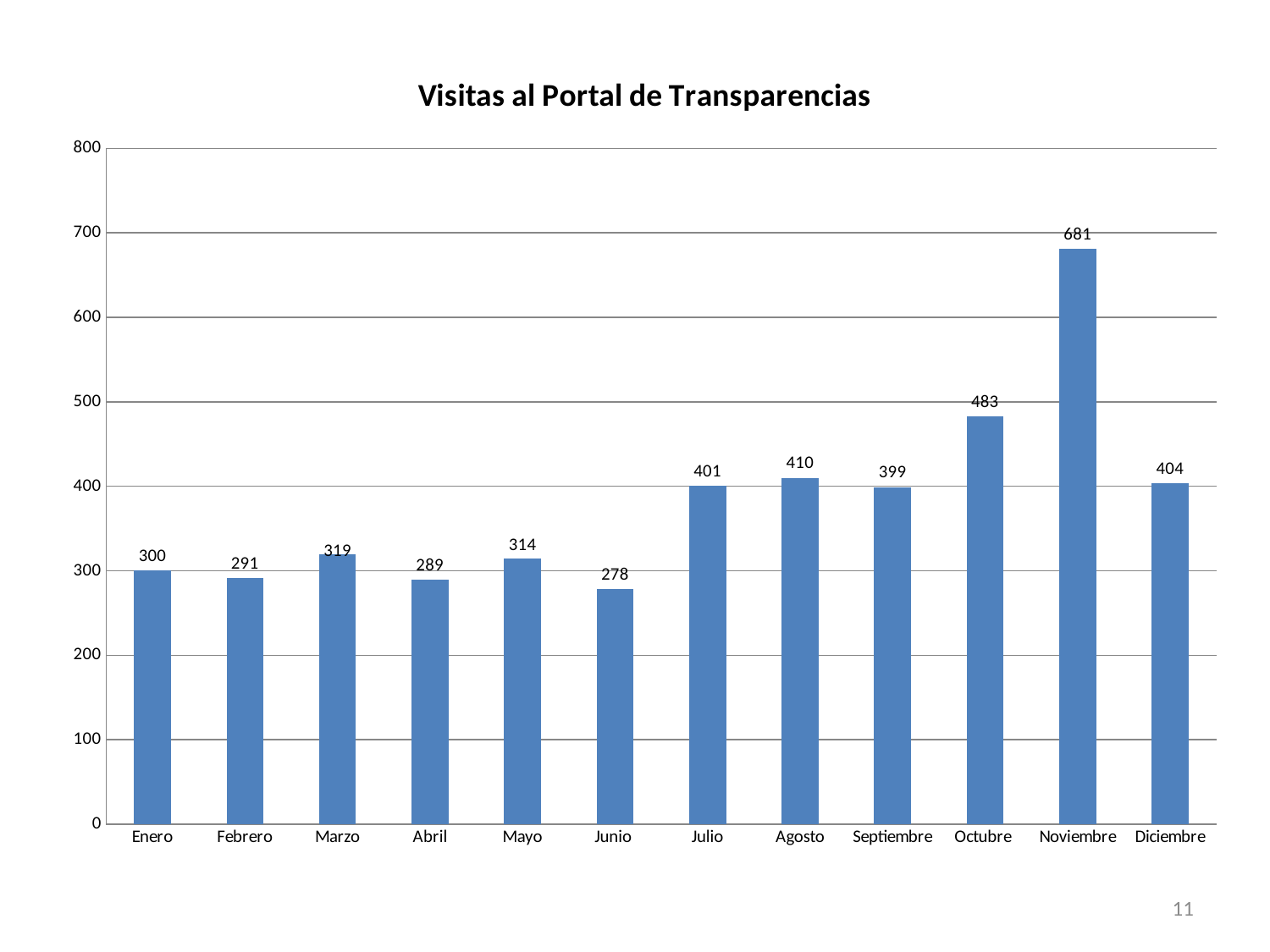
What is the value for Noviembre? 681 What is the value for Agosto? 410 Which month has the highest value? Noviembre What is the difference between the values for Noviembre and Octubre? 198 What kind of chart is shown on the slide? bar chart What is the title of the chart? Visitas al Portal de Transparencias Which is larger, the value for Marzo or the value for Mayo? Marzo Which month has the lowest value? Junio Is the value for Octubre greater or less than 500? less Do the values rise or fall from Junio to Noviembre? rise How many months are shown on the x axis? 12 What is the value for Junio? 278